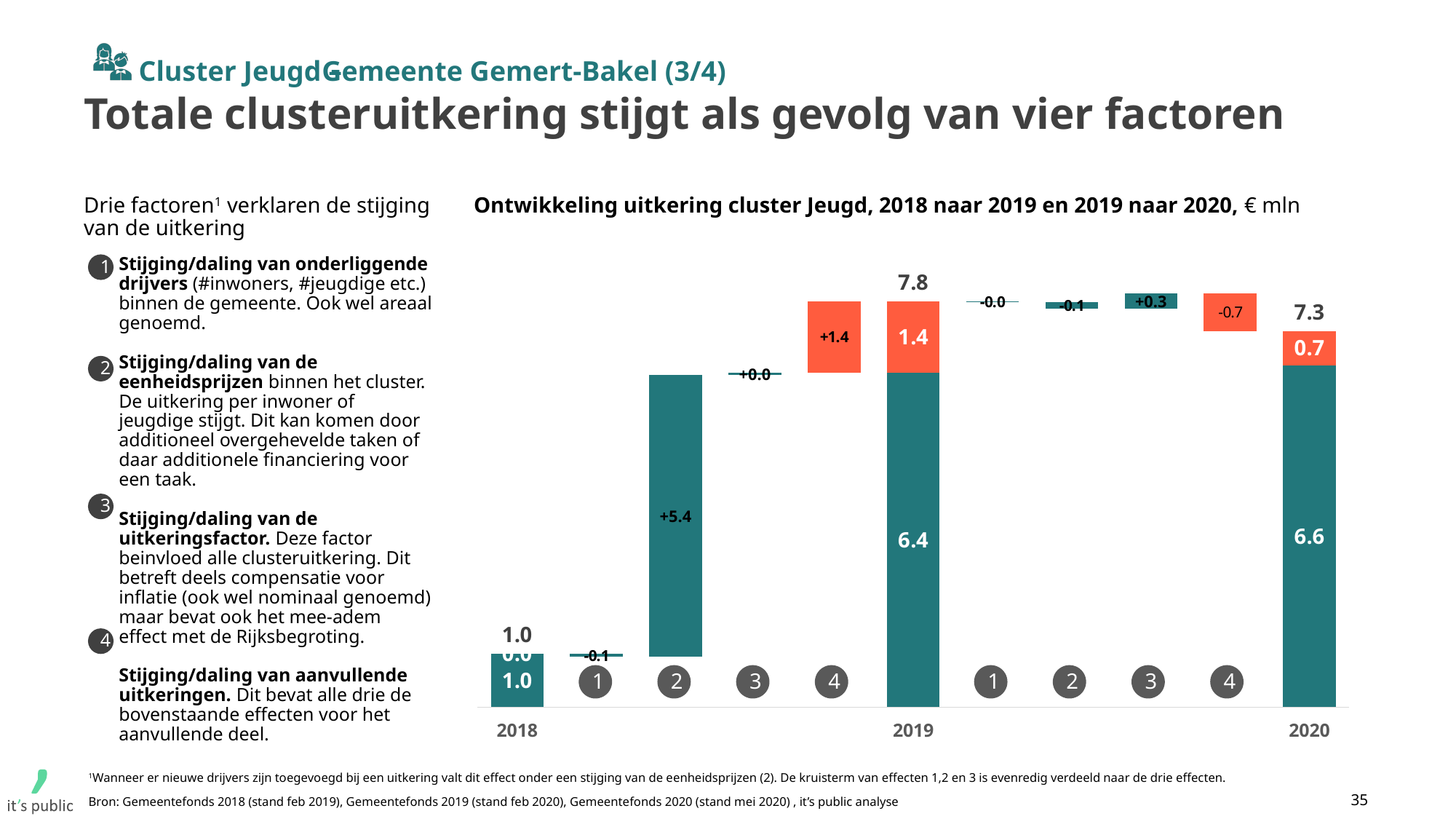
What is the total uitkering shown above the 2020 bar? 7.3 What is the change labelled for factor 2 between 2018 and 2019? +5.4 What value is printed in the teal (lower) segment of the 2019 bar? 6.4 What kind of chart is shown on the slide? Bar chart (waterfall) What is the change labelled for factor 4 between 2019 and 2020? -0.7 What is the change labelled for factor 4 between 2018 and 2019? +1.4 Which is larger, the total for 2019 or the total for 2020? 2019 What value is printed in the orange (upper) segment of the 2020 bar? 0.7 What is the total uitkering shown above the 2019 bar? 7.8 What is the difference between the 2019 total (7.8) and the 2020 total (7.3)? 0.5 What is the total uitkering shown above the 2018 bar? 1.0 Which year has the highest total uitkering? 2019